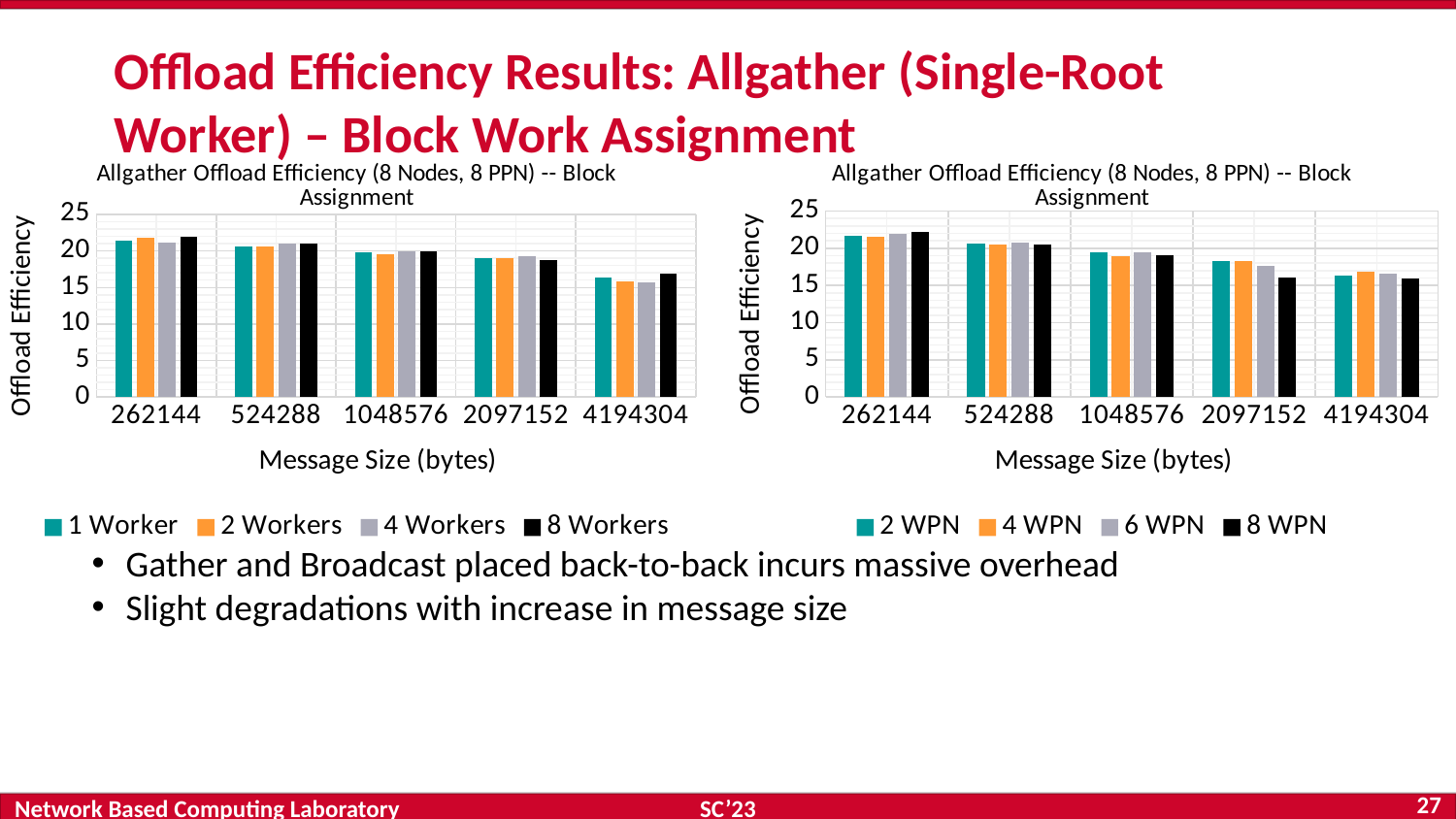
In the left chart, at which message size is the 8 Workers value lowest? 4194304 What type of chart is the left chart on the slide? bar chart In the left chart, do the values for 1 Worker rise or fall as message size increases along the x axis? fall In the right chart, is the value for 2 WPN at message size 262144 greater or less than 20? greater In the right chart, at which message size is the 2 WPN value highest? 262144 In the right chart, which is larger: the 8 WPN value at 262144 or the 8 WPN value at 2097152? 262144 How many message sizes are shown on the x axis of the left chart? 5 In the left chart, is the value for 1 Worker at message size 262144 greater or less than 20? greater In the left chart, is the value for 4 Workers at message size 4194304 greater or less than 20? less What is the x-axis title of the right chart? Message Size (bytes) How many series does the legend of the right chart list? 4